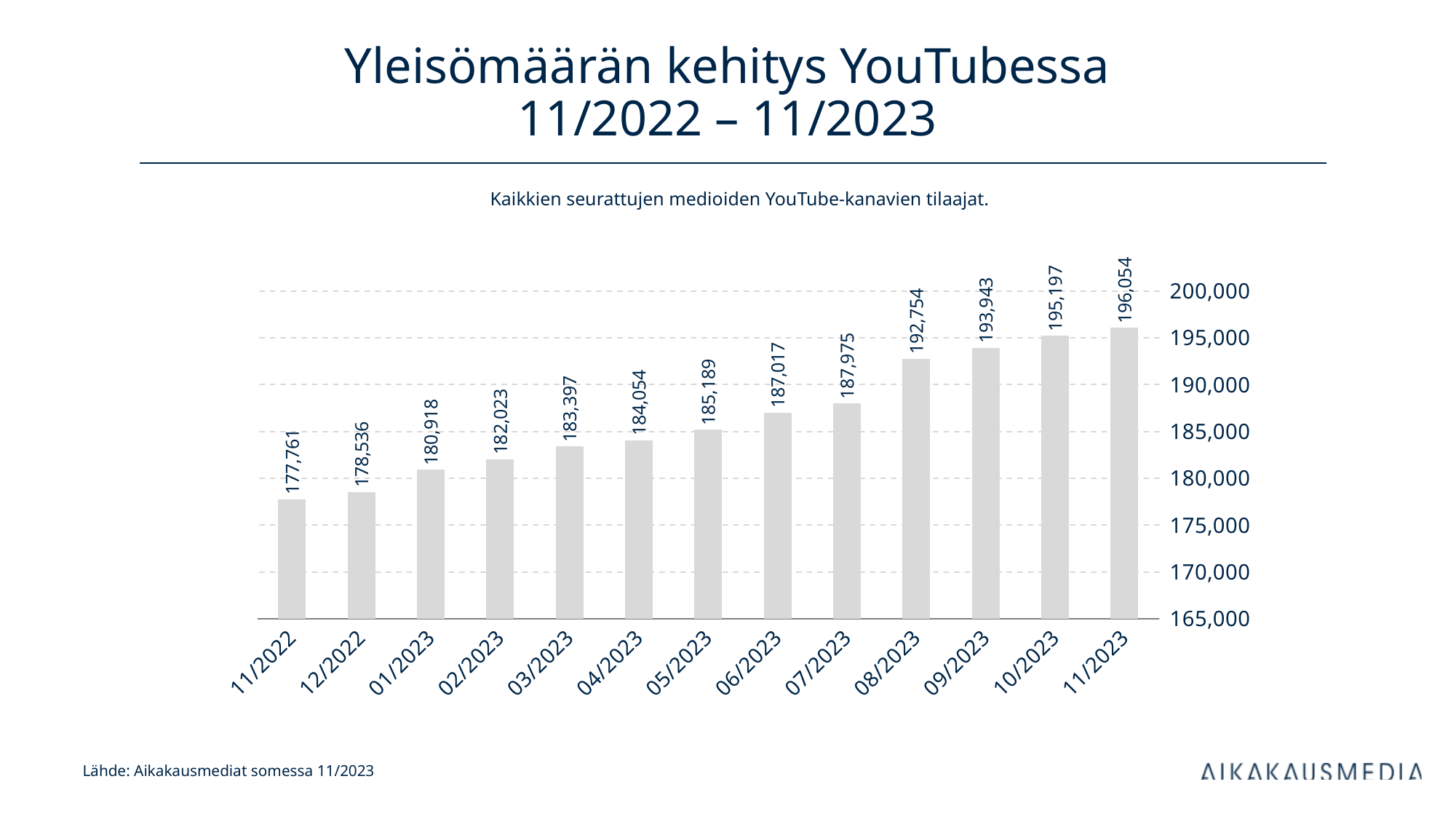
How many months are shown on the x axis? 13 Which month has the lowest value? 11/2022 What kind of chart is shown on the slide? bar chart What is the value for 11/2023? 196,054 Do the values rise or fall from 11/2022 to 11/2023? rise What is the value for 11/2022? 177,761 What is the value for 06/2023? 187,017 Which is larger, the value for 03/2023 or the value for 04/2023? 04/2023 What is the difference between the values for 11/2023 and 11/2022? 18,293 What is the difference between the values for 08/2023 and 07/2023? 4,779 Is the value for 09/2023 greater or less than 190,000? greater Which month has the highest value? 11/2023